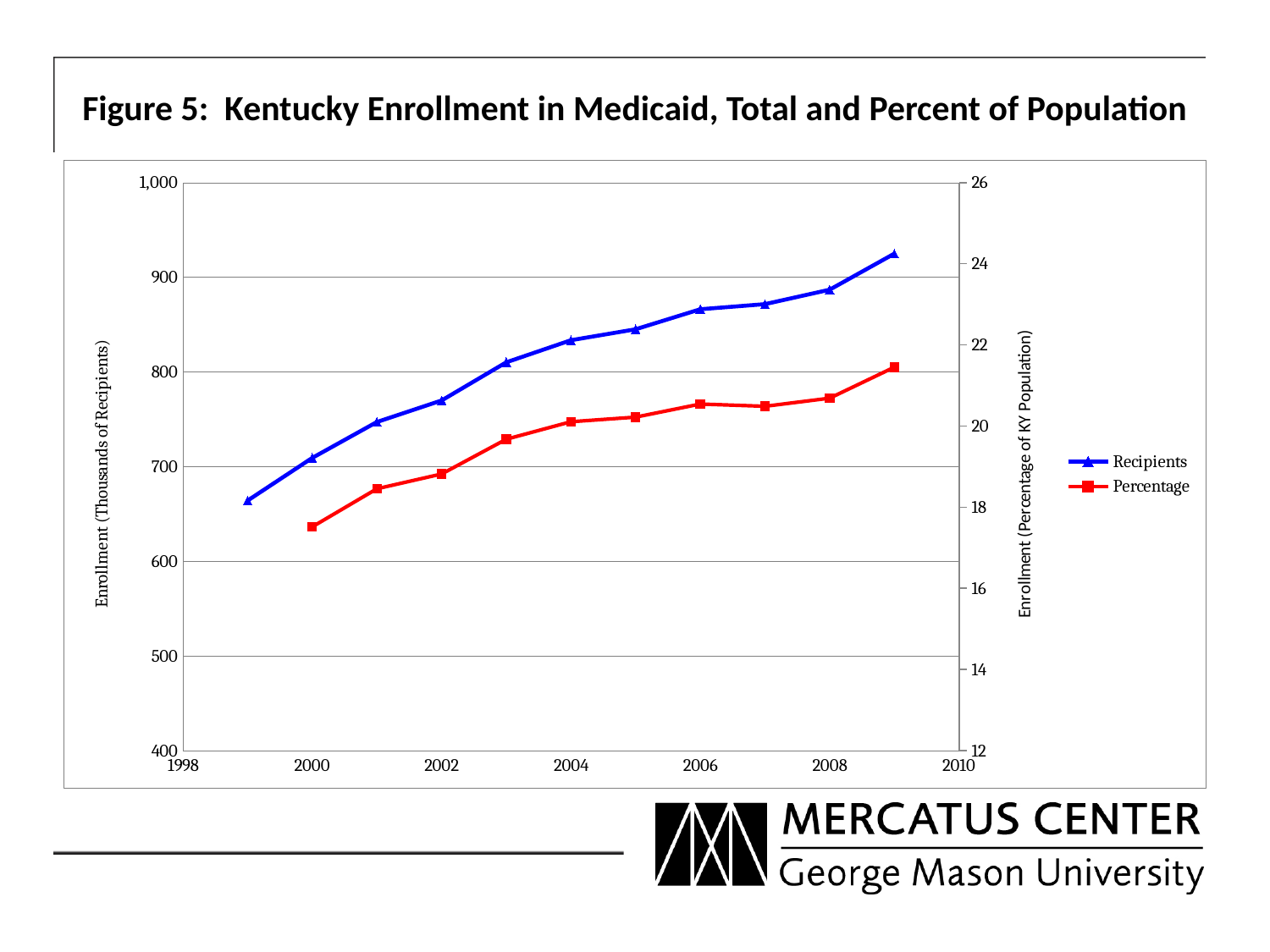
In which year is the Recipients series highest? 2009 Do the Percentage values rise or fall from 2000 to 2009? rise In which year is the Recipients series lowest? 1999 Is the Percentage value for 2000 greater or less than 18? less What kind of chart is shown on the slide? line chart What are the two series named in the legend? Recipients and Percentage Is the Recipients value for 2009 greater or less than 900? greater How many series does the legend list? 2 Is the Recipients value for 1999 greater or less than 700? less Do the Recipients values rise or fall from 1999 to 2009? rise What is the title of the chart? Figure 5: Kentucky Enrollment in Medicaid, Total and Percent of Population In which year is the Percentage series lowest? 2000